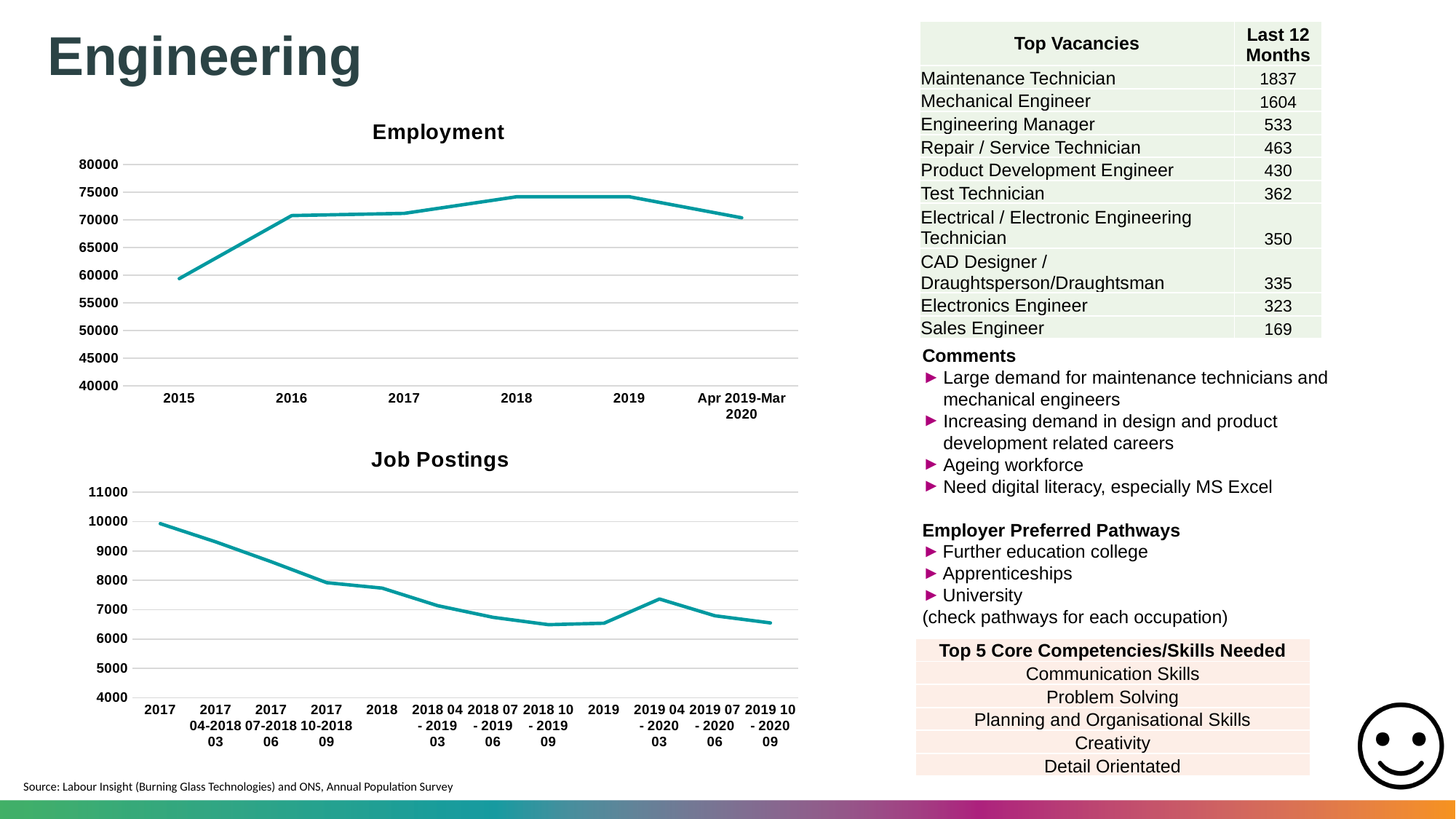
On the Job Postings chart, which period has the highest number of job postings? 2017 On the Employment chart, which is larger, the value for 2015 or the value for 2016? 2016 What type of chart is the Employment chart? line chart On the Employment chart, is the value for 2015 greater or less than 55000? greater On the Job Postings chart, is the value for 2017 greater or less than 9000? greater How many data points are plotted on the Employment chart? 6 On the Employment chart, is the value for 2018 greater or less than 70000? greater On the Employment chart, which year has the lowest employment? 2015 How many data points are plotted on the Job Postings chart? 12 On the Employment chart, does employment rise or fall from 2015 to 2018? rise On the Job Postings chart, do job postings rise or fall from 2017 to 2018 10 - 2019 09? fall